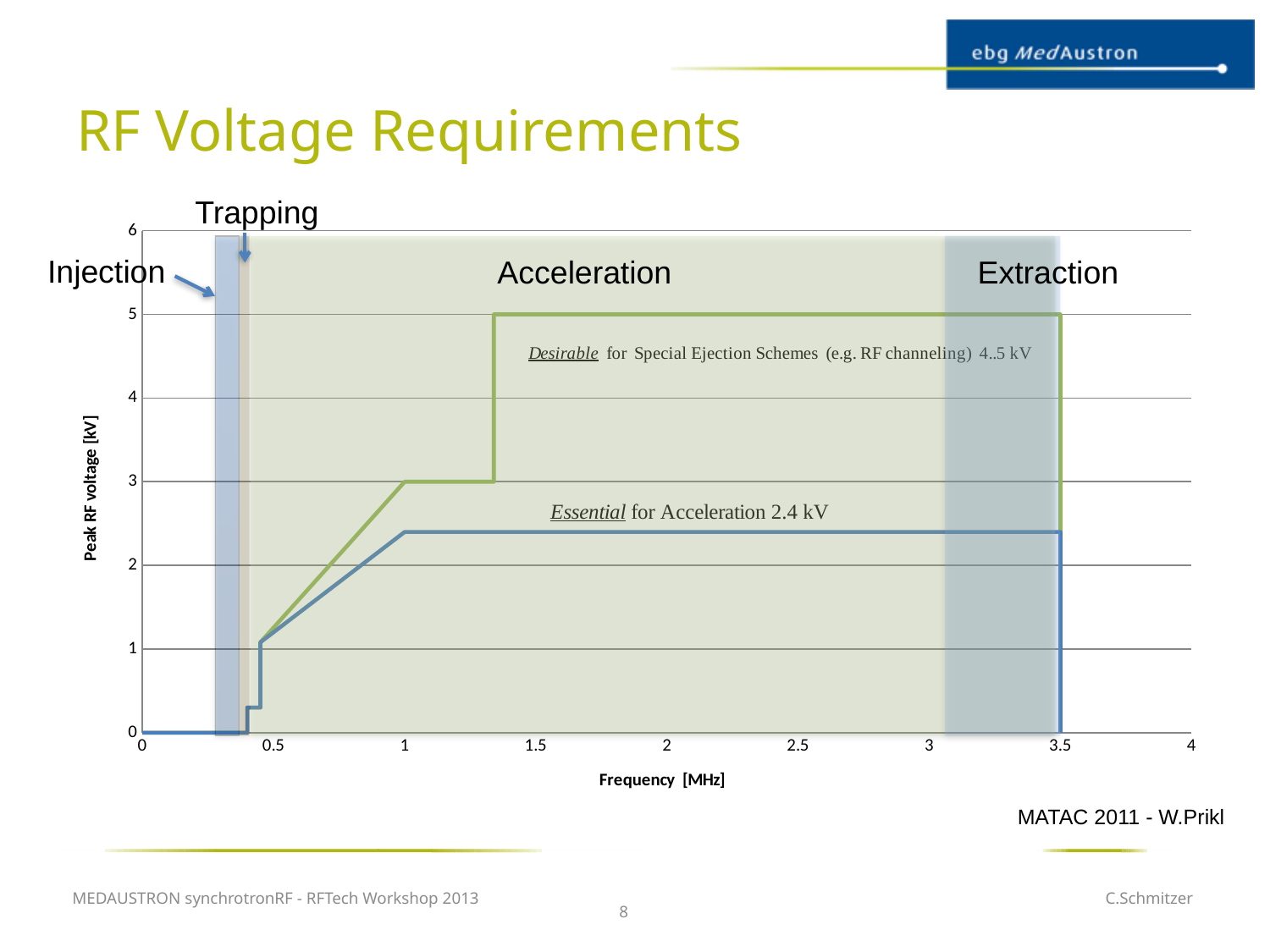
At 2 MHz, is the Desirable curve greater or less than 4 kV? greater At 3 MHz, is the Essential curve greater or less than 2 kV? greater What is the label of the y axis of the chart? Peak RF voltage [kV] Between 0.5 MHz and 1 MHz, does the Essential curve rise or fall? rise At 2.5 MHz, which curve is higher, the Desirable curve or the Essential curve? Desirable What kind of chart is shown on the slide? line chart What is the title of the chart on the slide? RF Voltage Requirements What voltage range is labelled as Desirable for Special Ejection Schemes? 4..5 kV At what frequency do both curves drop back to 0 kV at the right end? 3.5 MHz At 2 MHz, is the Essential curve greater or less than 3 kV? less What peak RF voltage is labelled as Essential for Acceleration? 2.4 kV What is the highest frequency tick shown on the x axis? 4